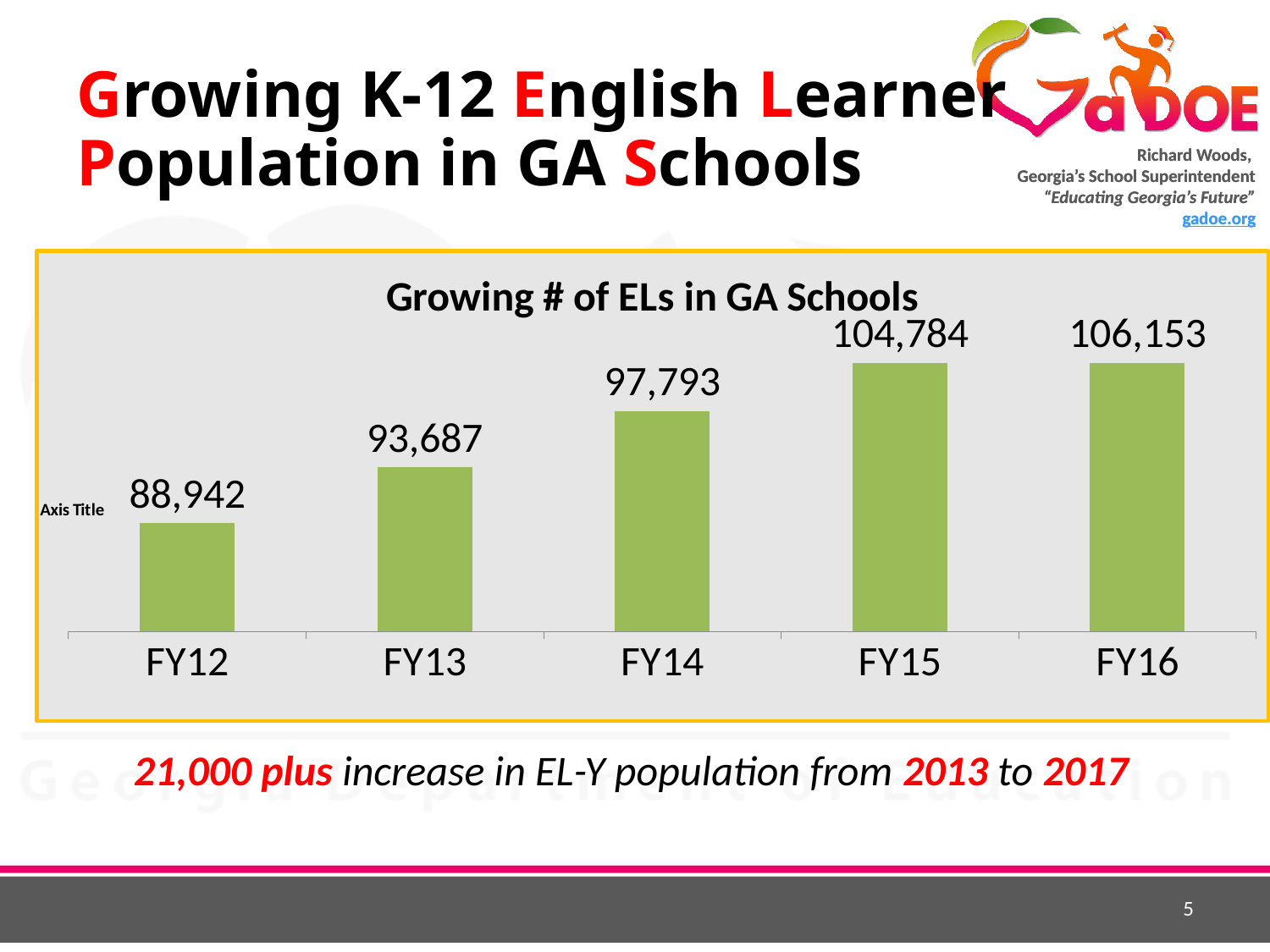
Which fiscal year has the lowest number of ELs? FY12 What is the value for FY12? 88,942 How many fiscal years are shown on the x axis? 5 Do the values rise or fall from FY12 to FY16? Rise What is the value for FY14? 97,793 What is the title of the chart? Growing # of ELs in GA Schools Which is larger, the value for FY13 or the value for FY14? FY14 What is the value for FY16? 106,153 What is the difference between the FY16 and FY12 values? 17,211 What is the difference between the FY15 and FY14 values? 6,991 What kind of chart is shown on the slide? Bar chart Which fiscal year has the highest number of ELs? FY16